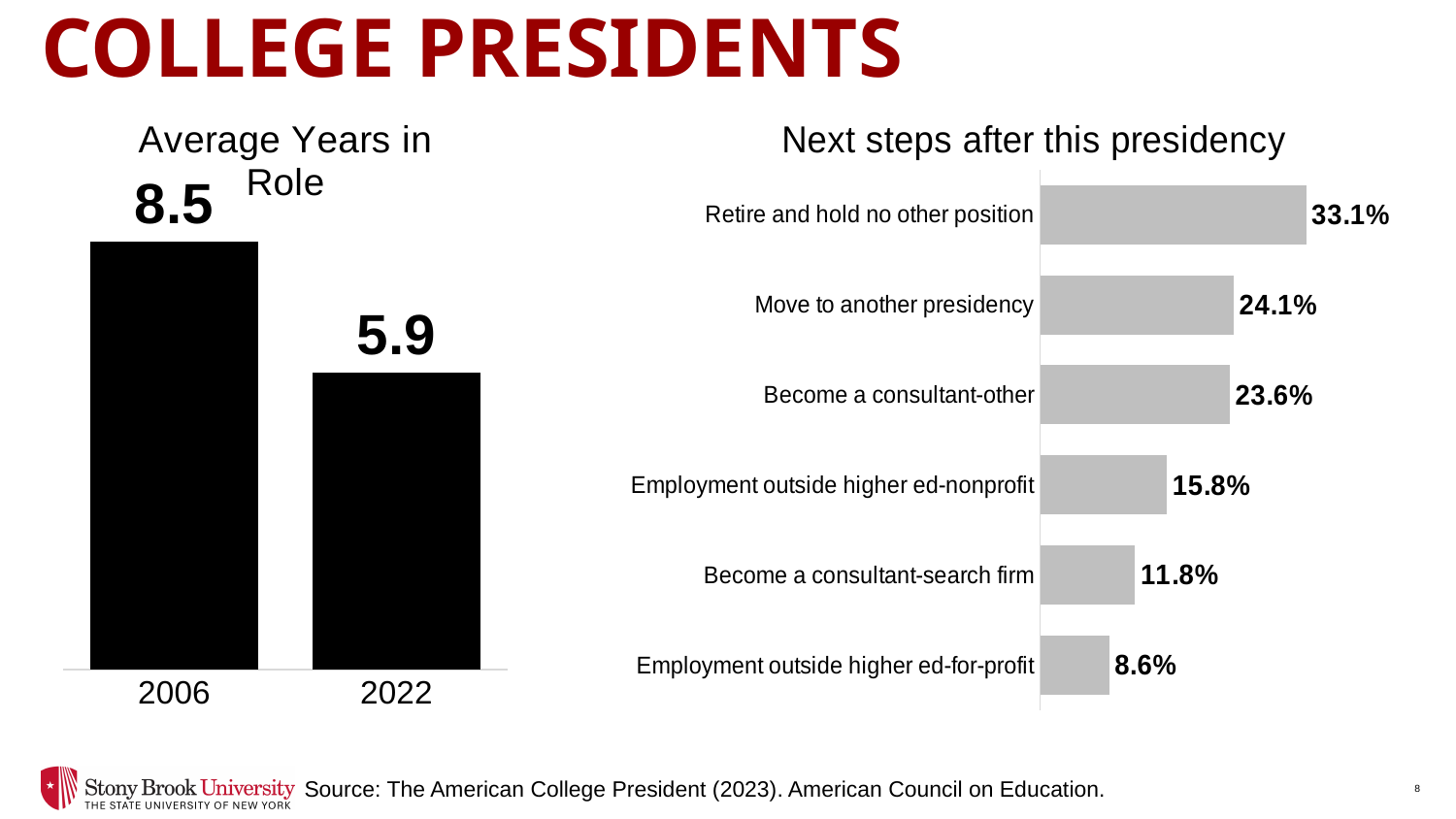
In the 'Next steps after this presidency' chart, what is the value for 'Employment outside higher ed-for-profit'? 8.6% In the 'Average Years in Role' chart, what is the value for 2022? 5.9 What kind of chart is the 'Next steps after this presidency' chart? bar chart In the 'Next steps after this presidency' chart, which category has the highest value? Retire and hold no other position In the 'Average Years in Role' chart, what is the value for 2006? 8.5 In the 'Next steps after this presidency' chart, which category has the lowest value? Employment outside higher ed-for-profit In the 'Average Years in Role' chart, what is the difference between the 2006 and 2022 values? 2.6 In the 'Average Years in Role' chart, do the values rise or fall from 2006 to 2022? fall In the 'Average Years in Role' chart, how many categories are shown? 2 In the 'Next steps after this presidency' chart, what is the difference between 'Retire and hold no other position' and 'Become a consultant-search firm'? 21.3% In the 'Next steps after this presidency' chart, which is larger: 'Employment outside higher ed-nonprofit' or 'Become a consultant-search firm'? Employment outside higher ed-nonprofit In the 'Next steps after this presidency' chart, what is the value for 'Move to another presidency'? 24.1%